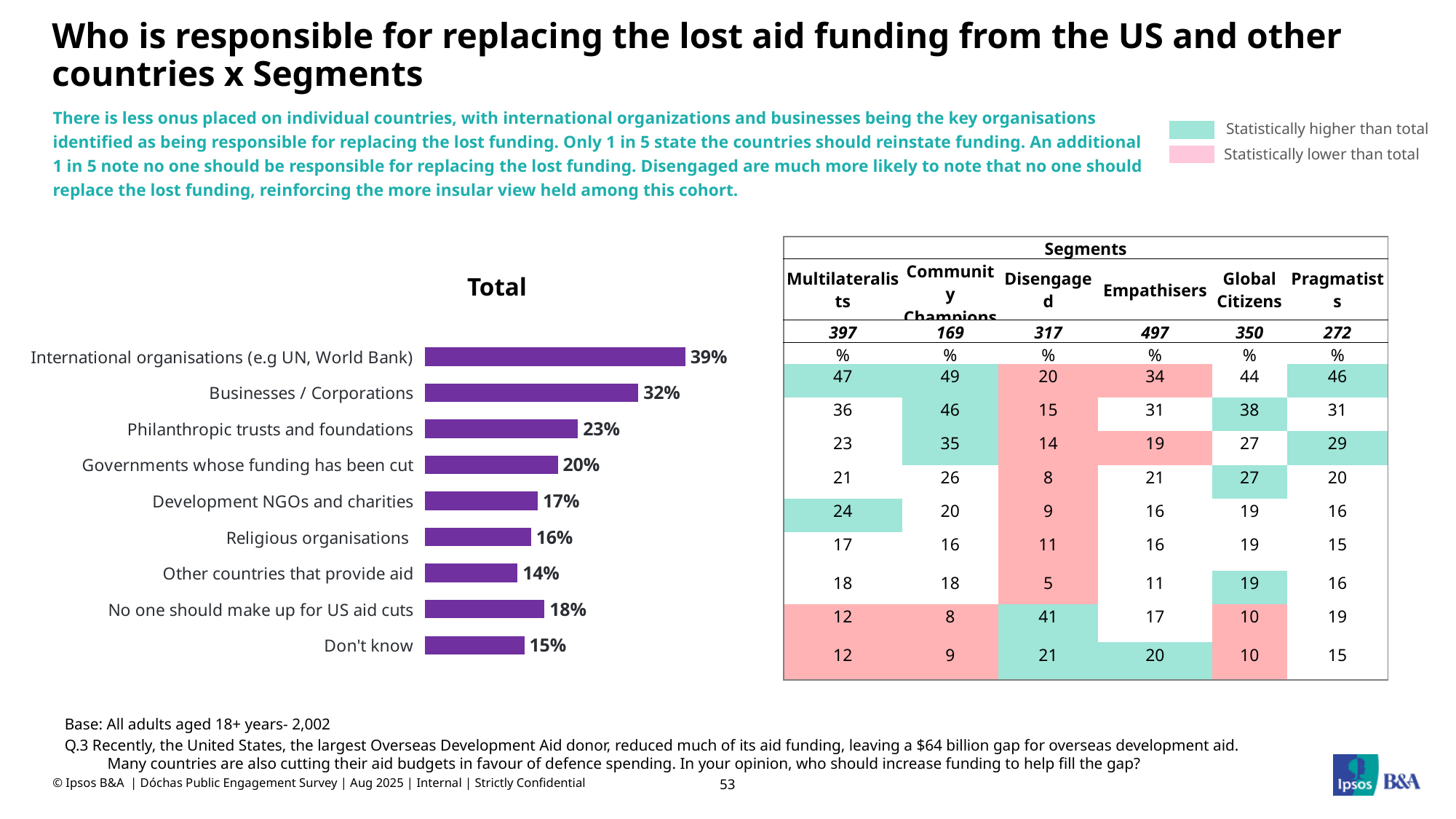
In the "Total" bar chart, what is the difference between the values for Philanthropic trusts and foundations and Governments whose funding has been cut? 3% In the "Total" bar chart, which category has the lowest value? Other countries that provide aid In the "Total" bar chart, what is the value for Don't know? 15% In the "Total" bar chart, what is the value for No one should make up for US aid cuts? 18% In the "Total" bar chart, which is larger: Development NGOs and charities or Religious organisations? Development NGOs and charities In the "Total" bar chart, what is the difference between the values for International organisations (e.g UN, World Bank) and Businesses / Corporations? 7% How many categories are shown in the "Total" bar chart? 9 In the "Total" bar chart, what is the value for Businesses / Corporations? 32% What is the title of the bar chart on the slide? Total What kind of chart is the "Total" chart? Bar chart In the "Total" bar chart, which category has the highest value? International organisations (e.g UN, World Bank) In the "Total" bar chart, what is the value for International organisations (e.g UN, World Bank)? 39%